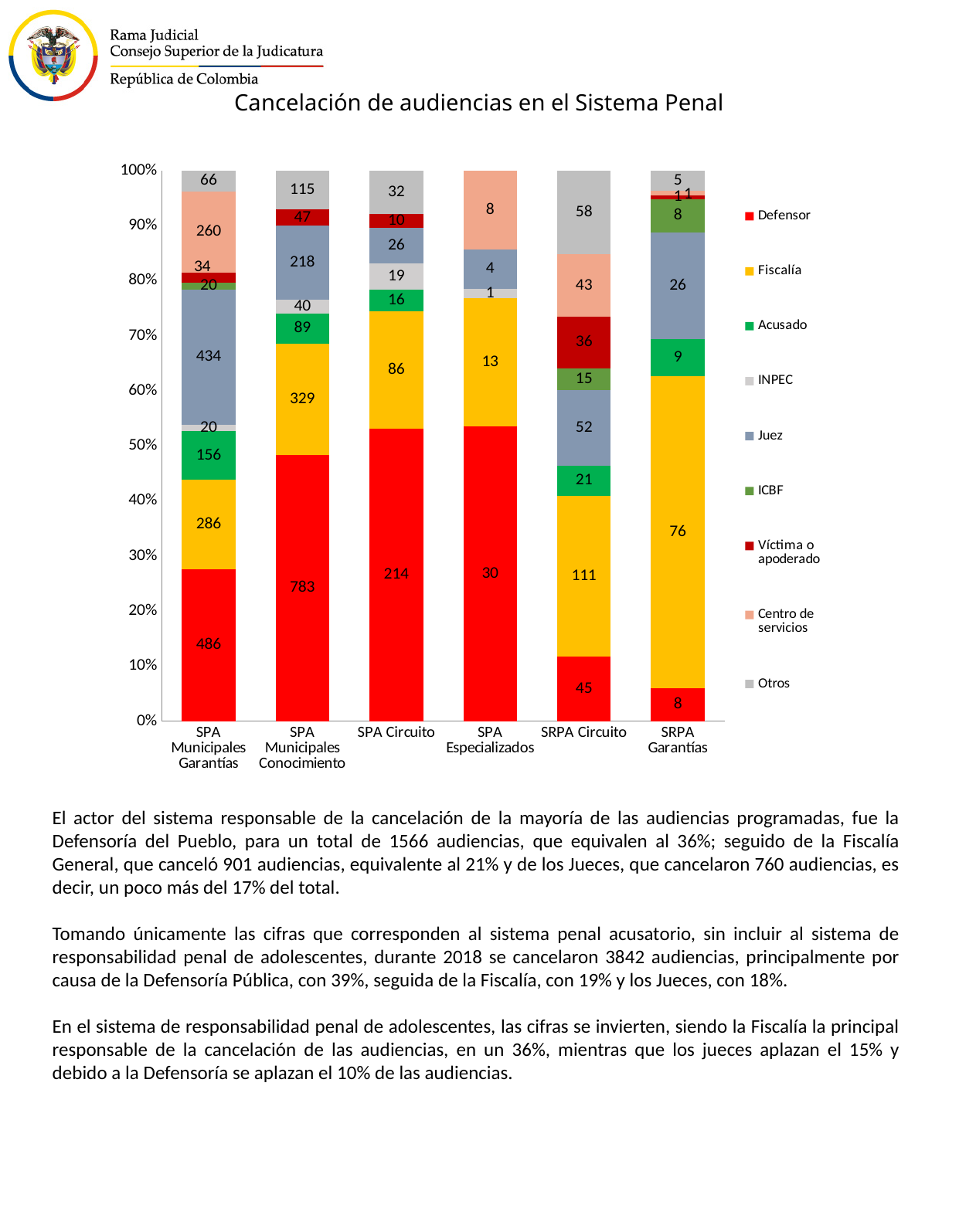
What is the Otros value for SPA Circuito? 32 How many categories are shown on the x axis of the chart? 6 In SRPA Circuito, which is larger: the Defensor value or the Fiscalía value? Fiscalía What is the Centro de servicios value for SPA Especializados? 8 What is the difference between the Fiscalía values for SPA Municipales Conocimiento and SPA Municipales Garantías? 43 What is the Fiscalía value for SRPA Circuito? 111 What kind of chart is shown on the slide? Stacked bar chart How many series does the chart's legend list? 9 What is the Juez value for SPA Municipales Garantías? 434 What is the title of the chart? Cancelación de audiencias en el Sistema Penal What is the Defensor value for SPA Municipales Conocimiento? 783 Which category has the highest Defensor value? SPA Municipales Conocimiento